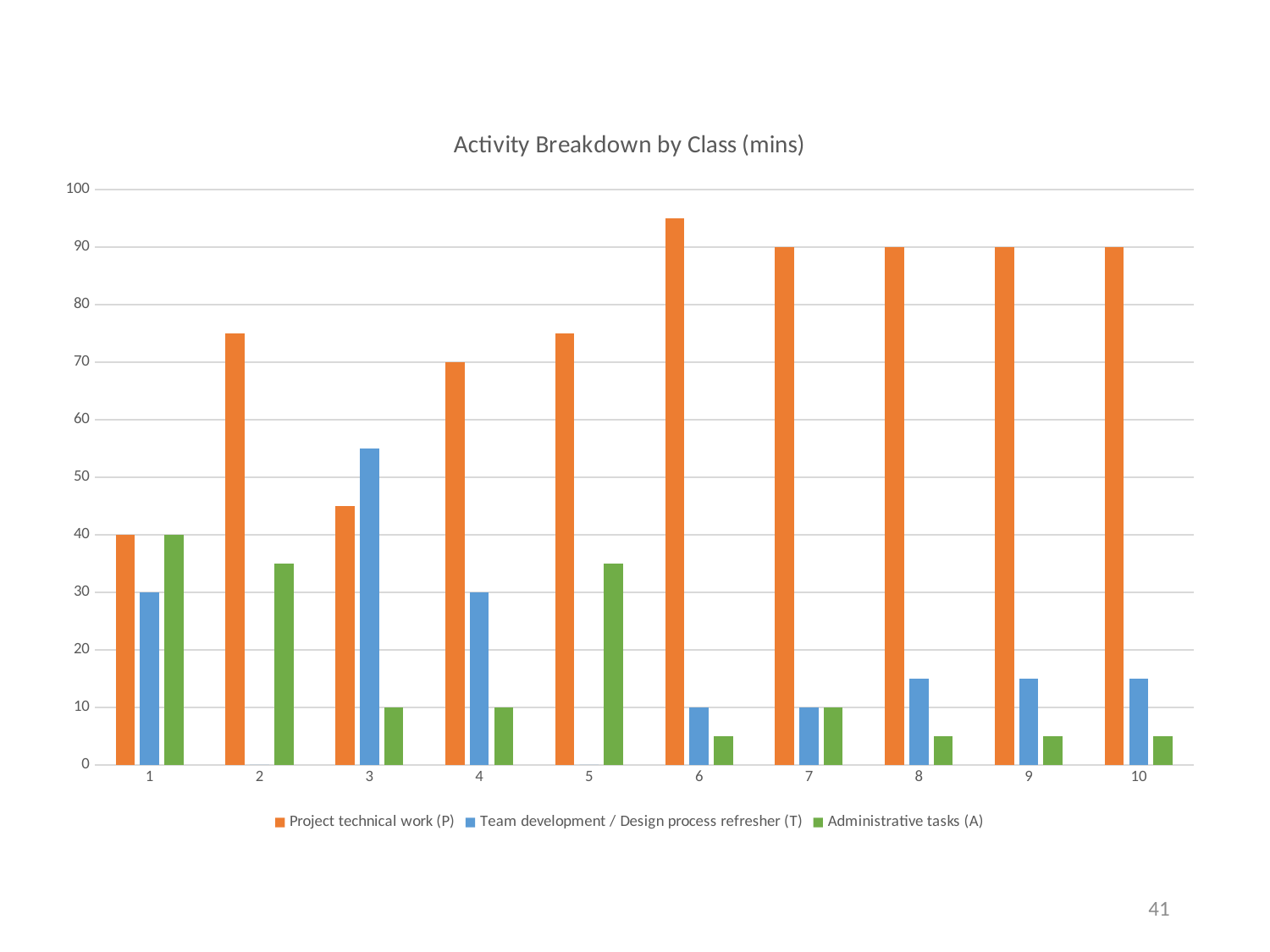
What is the value of Team development / Design process refresher (T) for class 1? 30 For class 3, which is larger: Project technical work (P) or Team development / Design process refresher (T)? Team development / Design process refresher (T) What is the value of Project technical work (P) for class 1? 40 What type of chart is shown on the slide? Bar chart How many series does the legend list? 3 For which class is Project technical work (P) highest? 6 What is the value of Project technical work (P) for class 4? 70 How many classes are shown on the x axis? 10 What is the difference between Project technical work (P) for class 4 and for class 1? 30 What is the title of the chart? Activity Breakdown by Class (mins) For which class is Team development / Design process refresher (T) highest? 3 Is the value of Project technical work (P) for class 6 greater or less than 90? greater